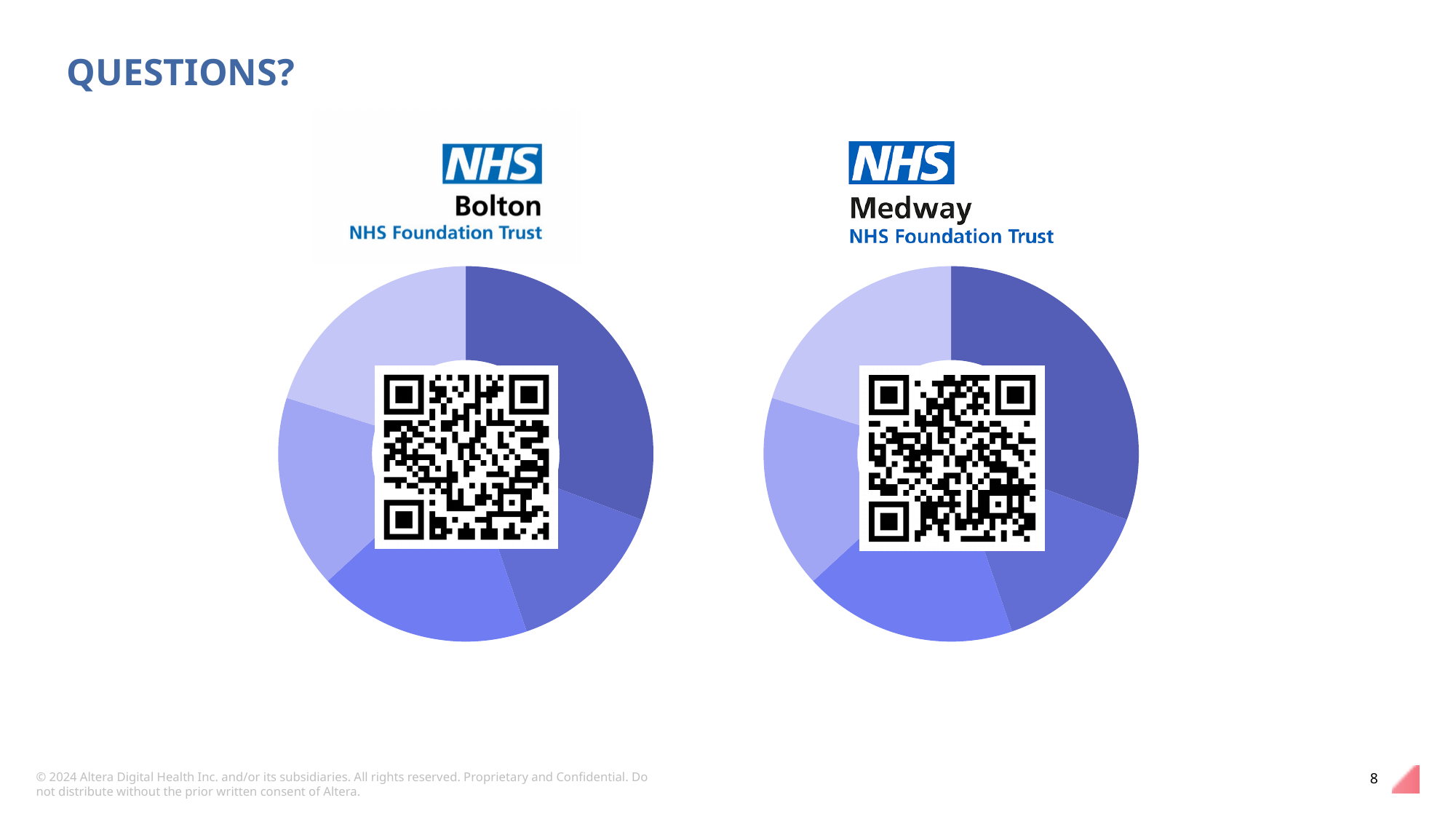
How many slices does the pie chart under the Bolton NHS Foundation Trust logo have? 5 How many pie charts are on the slide? 2 How many slices does the pie chart under the Medway NHS Foundation Trust logo have? 5 Does either pie chart on the slide show a legend? No What kind of chart is shown under the Bolton NHS Foundation Trust logo? doughnut chart In the pie chart under the Medway NHS Foundation Trust logo, which colour slice is the largest? the dark blue slice In the pie chart under the Bolton NHS Foundation Trust logo, which colour slice is the largest? the dark blue slice What kind of chart is shown under the Medway NHS Foundation Trust logo? doughnut chart